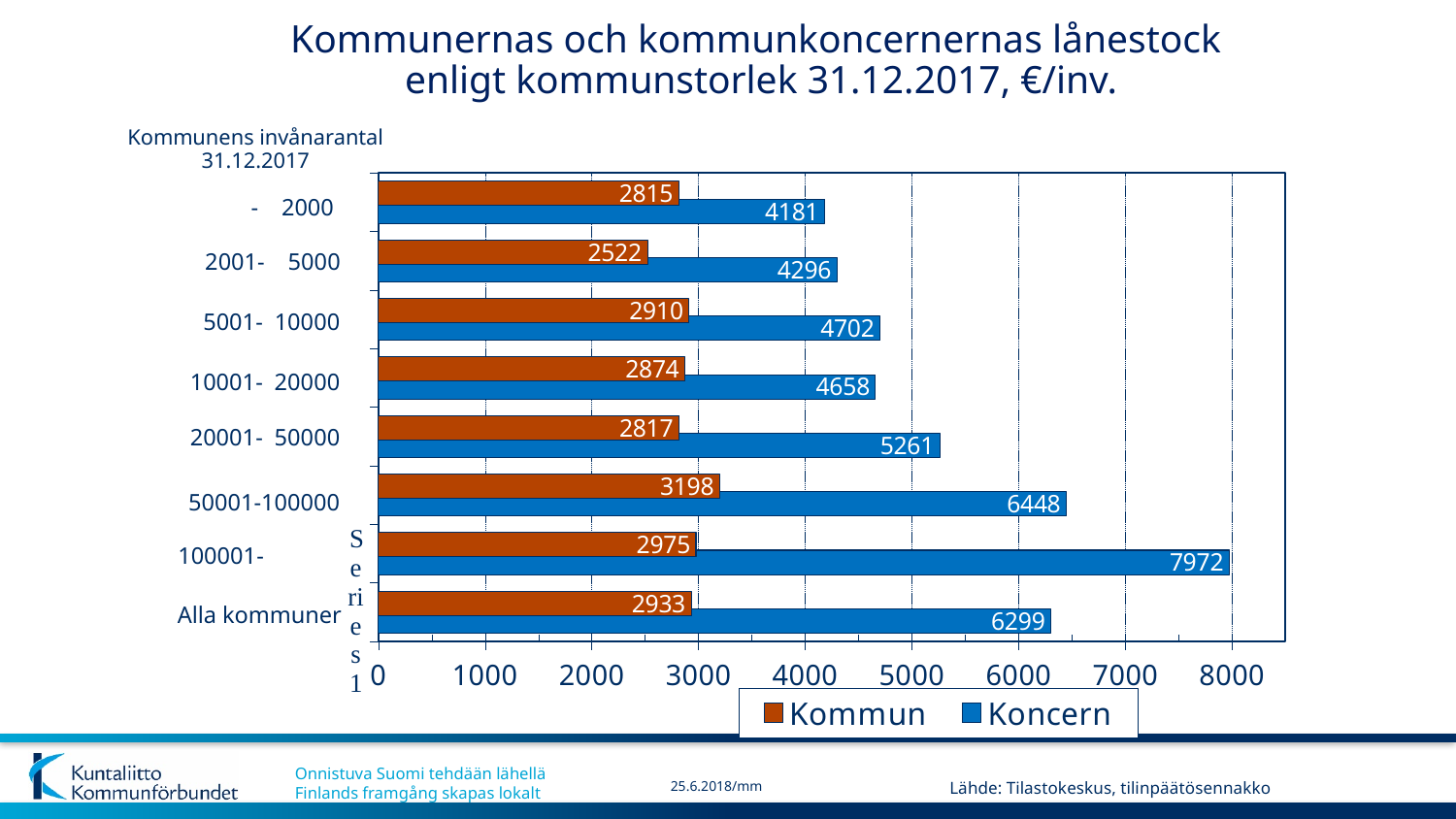
What is the difference between the Koncern and Kommun values for the 20001- 50000 category? 2444 How many series does the legend list? 2 What is the Kommun value for the 2001- 5000 category? 2522 What is the Kommun value for the 50001-100000 category? 3198 Is the Koncern value for the 50001-100000 category greater or less than 6000? greater What kind of chart is shown on the slide? bar chart What is the Koncern value for the 100001- category? 7972 Which category has the highest Koncern value? 100001- How many categories are shown on the chart? 8 Which is larger, the Koncern value for 5001- 10000 or the Koncern value for 10001- 20000? 5001- 10000 What is the Koncern value for Alla kommuner? 6299 Which category has the lowest Kommun value? 2001- 5000